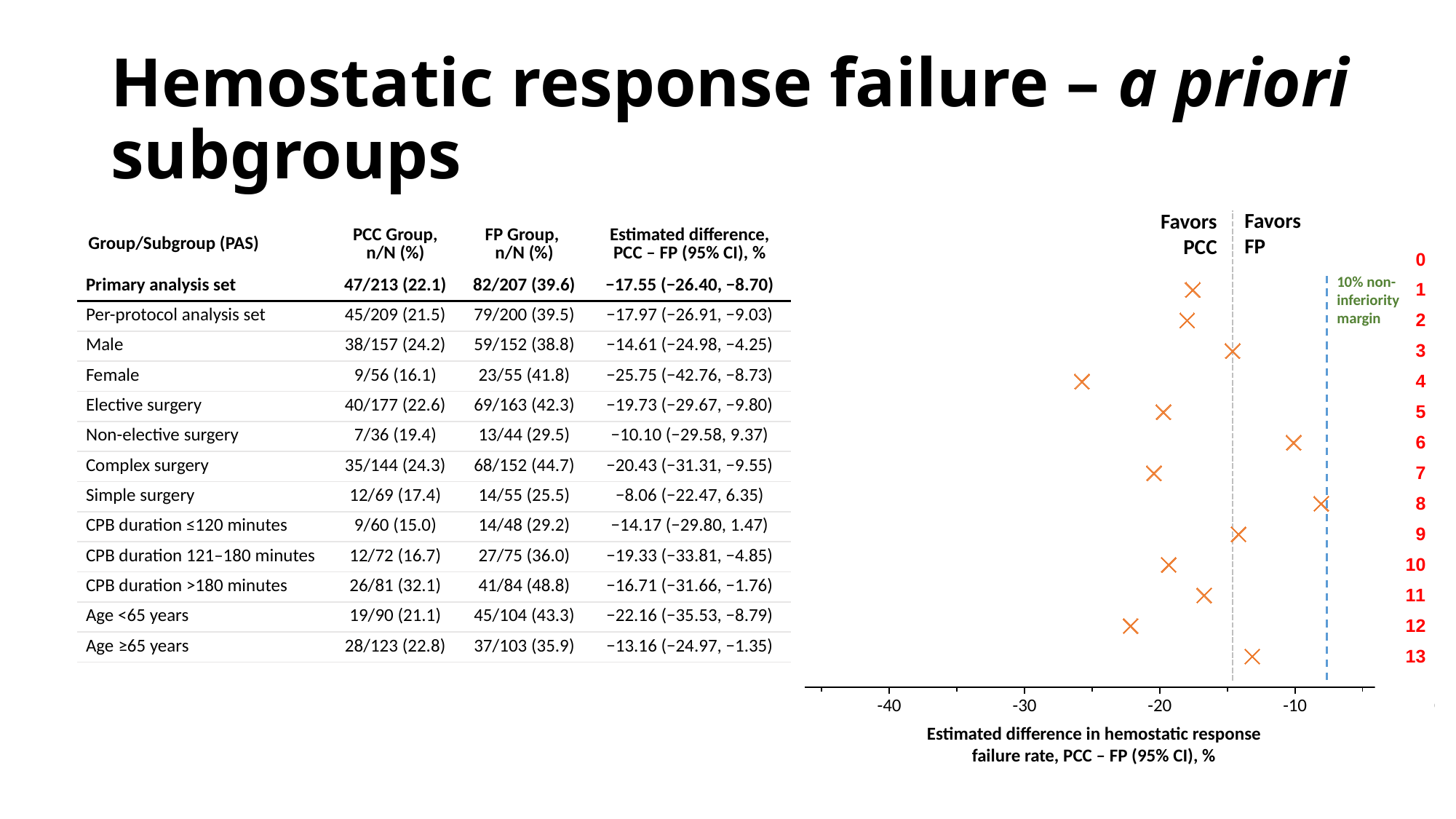
Which subgroup has the highest (closest to zero) estimated difference in the chart? Simple surgery Is the value plotted for row 4 (Female) greater or less than -20? less What does the blue dashed vertical line in the chart represent? 10% non-inferiority margin Is the value plotted for row 12 (Age <65 years) greater or less than -20? less What kind of chart is shown on the right of the slide? scatter plot What is the difference between the estimated differences for Female (−25.75) and Male (−14.61)? 11.14 Which has the larger (less negative) estimated difference, Male or Female? Male Is the value plotted for row 8 (Simple surgery) greater or less than -10? greater In the chart on the right, what is the estimated difference plotted for row 4 (Female)? −25.75 How many data points are plotted in the chart on the right? 13 Which subgroup has the lowest (most negative) estimated difference in the chart? Female In the chart on the right, what is the estimated difference plotted for row 1 (Primary analysis set)? −17.55